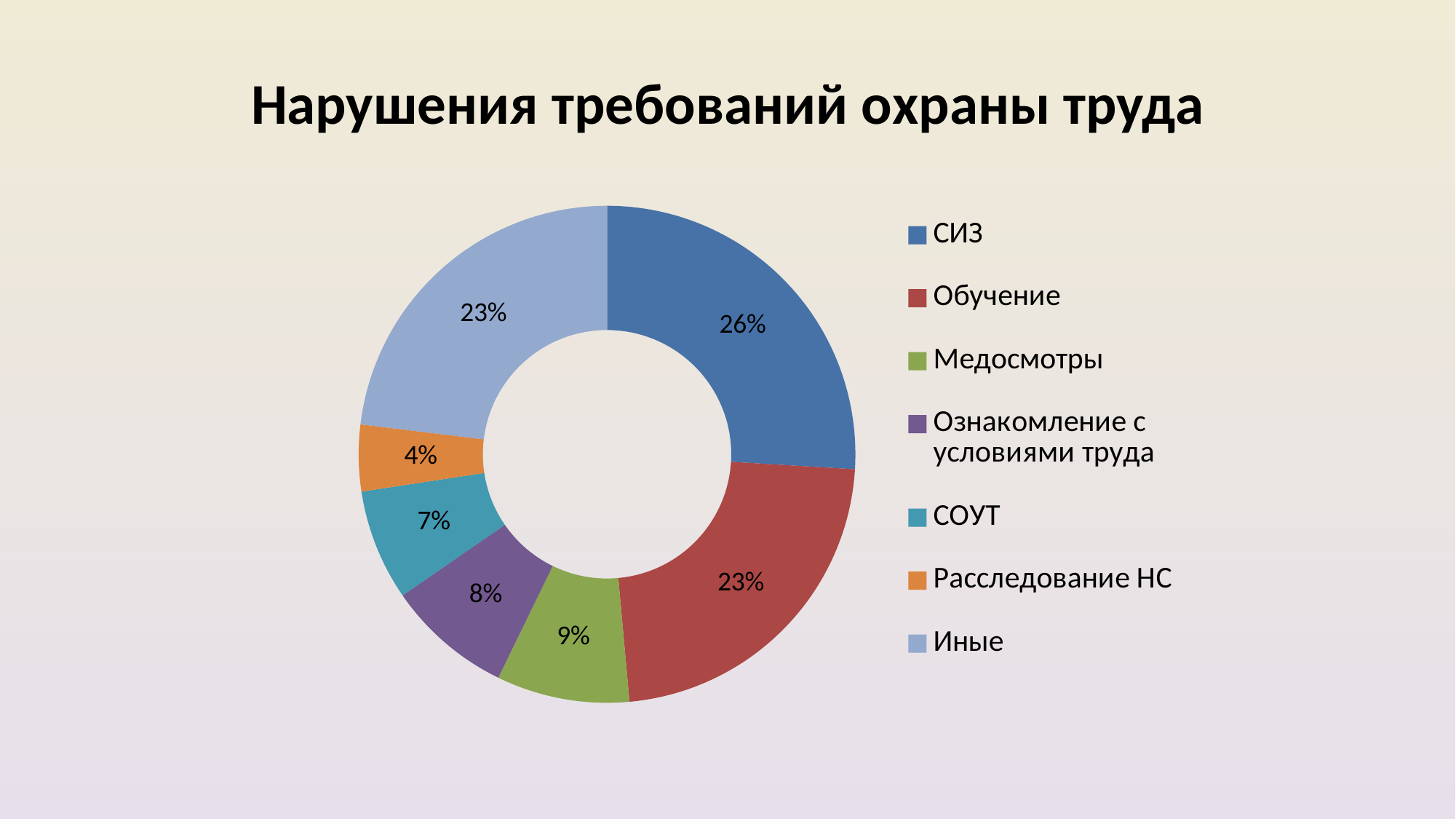
What percentage is shown for Медосмотры? 9% Which category has the largest share? СИЗ Which category has the smallest share? Расследование НС What kind of chart is shown on the slide? Doughnut (pie) chart What is the value for Расследование НС? 4% What is the value for СОУТ? 7% What is the difference between the shares of СИЗ and Ознакомление с условиями труда? 18% What is the value shown for Обучение? 23% What share of the chart does СИЗ account for? 26% What is the title of the chart? Нарушения требований охраны труда Which is larger, the share for Медосмотры or the share for СОУТ? Медосмотры How many categories does the chart show? 7